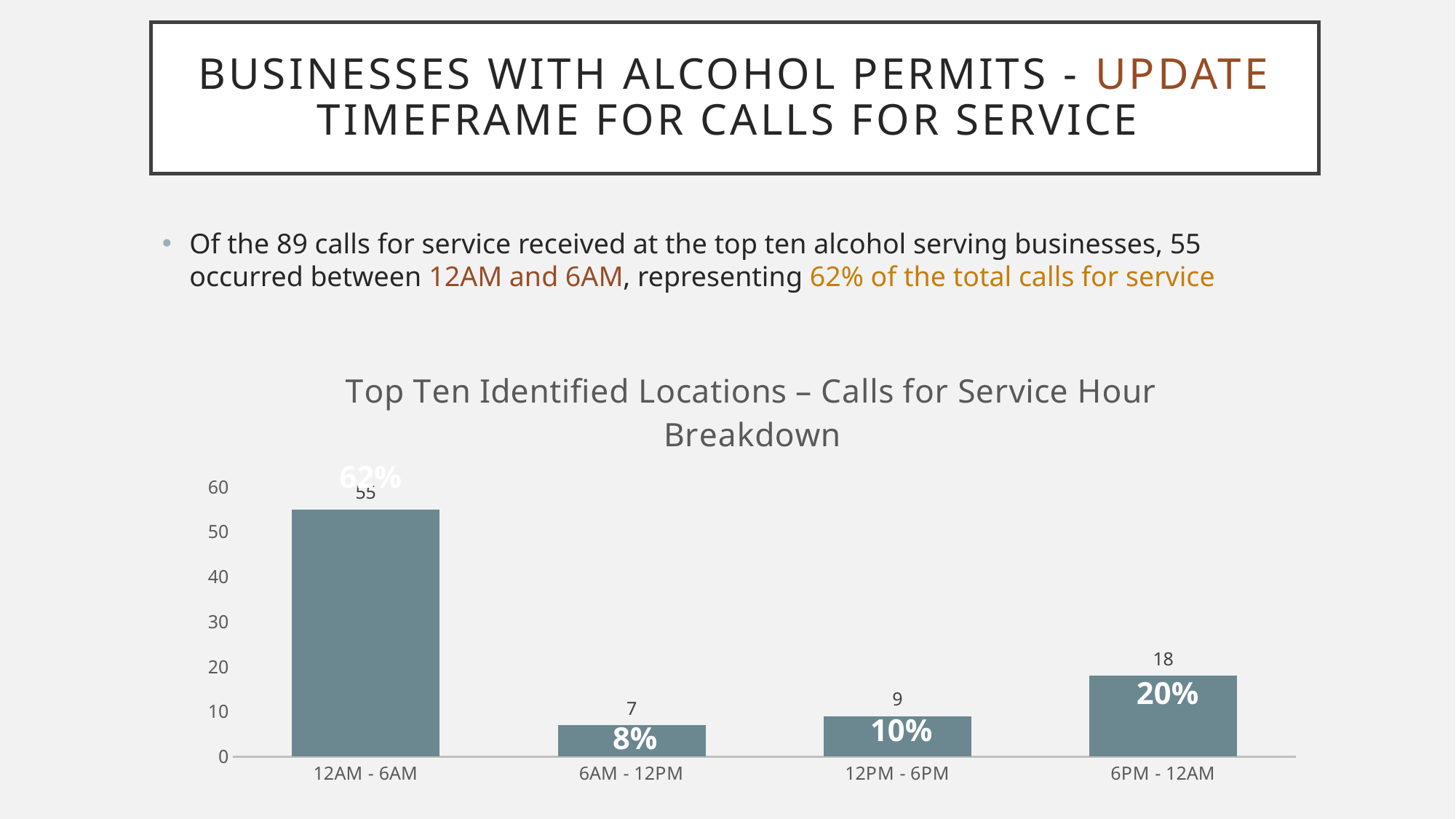
Which is larger, the value for 12PM - 6PM or the value for 6AM - 12PM? 12PM - 6PM Which time period has the highest number of calls for service? 12AM - 6AM What is the value for 6AM - 12PM? 7 What is the value for 12PM - 6PM? 9 What is the title of the chart? Top Ten Identified Locations – Calls for Service Hour Breakdown What is the value for 6PM - 12AM? 18 What kind of chart is shown on the slide? Bar chart What percentage label is shown on the bar for 6PM - 12AM? 20% What is the value for 12AM - 6AM? 55 Which time period has the lowest number of calls for service? 6AM - 12PM What is the difference between the values for 12AM - 6AM and 6PM - 12AM? 37 How many time period categories are shown on the x axis? 4